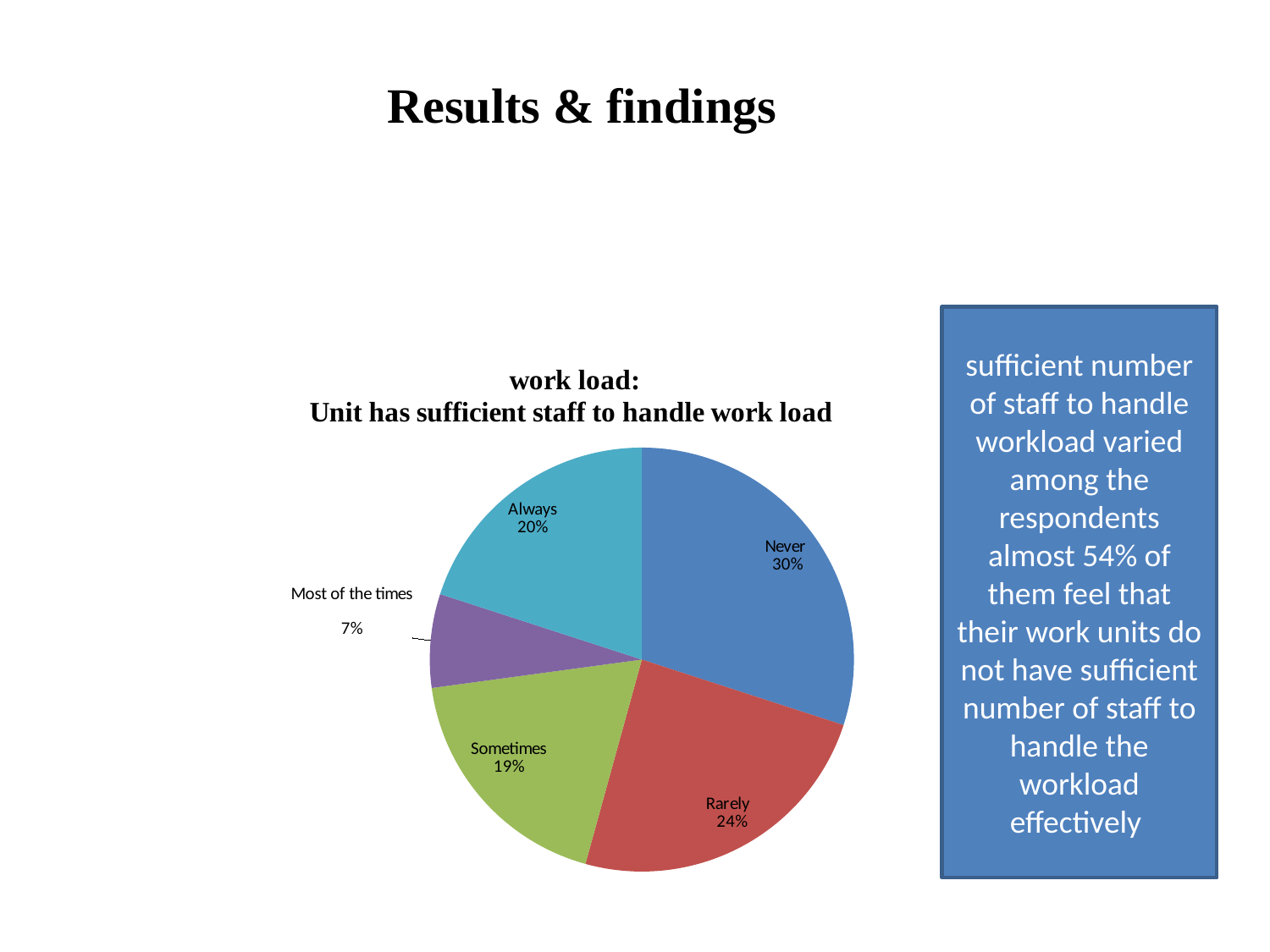
What is the difference in percentage points between "Never" and "Rarely"? 6 Which is larger, the share for "Always" or the share for "Sometimes"? Always What is the title of the pie chart? work load: Unit has sufficient staff to handle work load How many categories are shown in the pie chart? 5 What type of chart is shown on the slide? pie chart What percentage of respondents answered "Most of the times"? 7% What percentage of respondents answered "Sometimes"? 19% What percentage of respondents answered "Rarely"? 24% What percentage of respondents answered "Never"? 30% Which category has the smallest share of the pie? Most of the times What percentage of respondents answered "Always"? 20% Which category has the largest share of the pie? Never